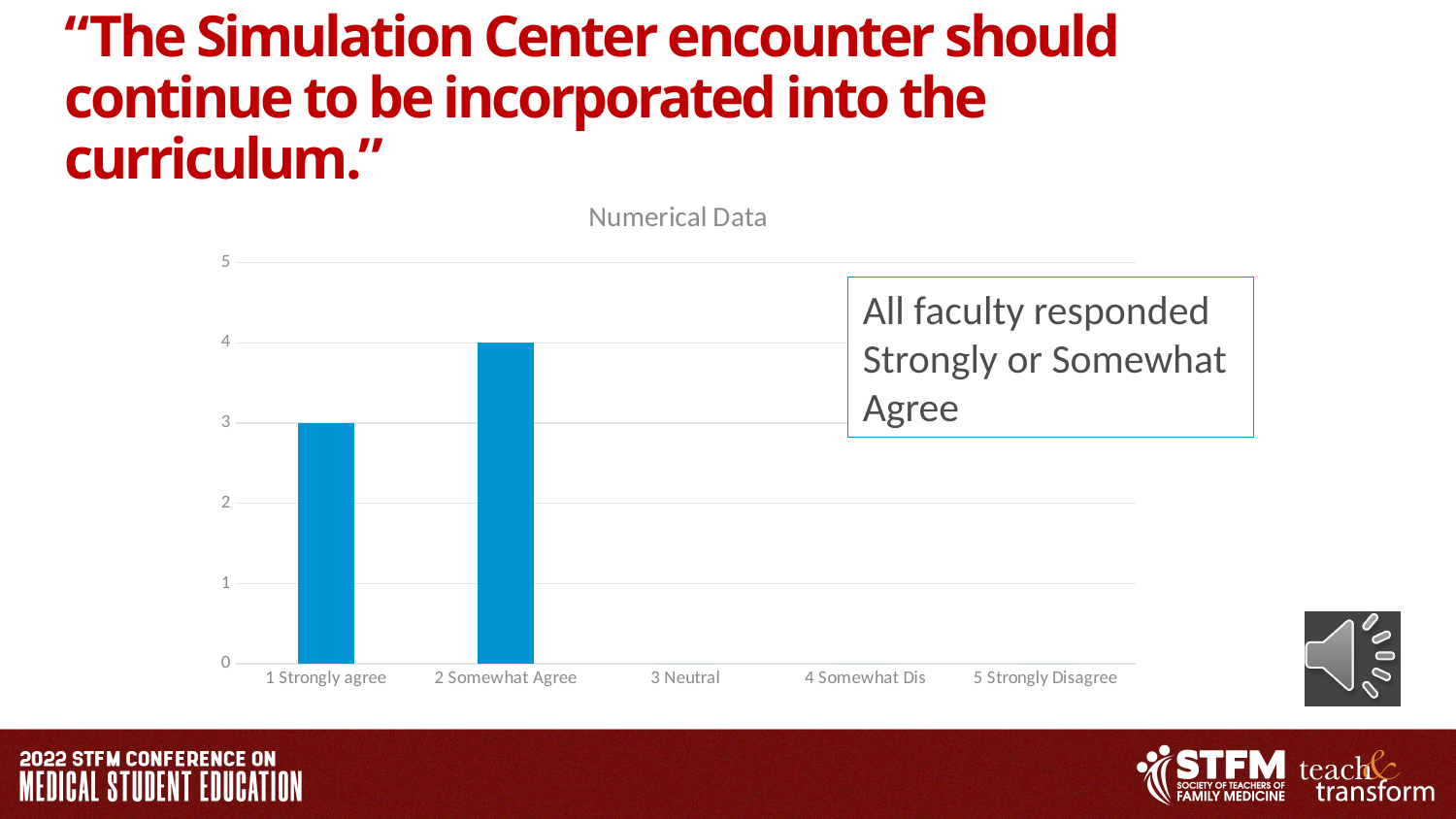
What is the difference between the values for "2 Somewhat Agree" and "1 Strongly agree"? 1 What does the text box on the chart say? All faculty responded Strongly or Somewhat Agree What is the value for "3 Neutral"? 0 What is the value for "2 Somewhat Agree"? 4 What kind of chart is shown on the slide? bar chart What is the total of the values for "1 Strongly agree" and "2 Somewhat Agree"? 7 What is the title of the chart? Numerical Data Which category has the highest value? 2 Somewhat Agree Is the value for "2 Somewhat Agree" greater or less than 5? less What is the value for "1 Strongly agree"? 3 Which is larger, the value for "1 Strongly agree" or the value for "2 Somewhat Agree"? 2 Somewhat Agree How many categories are shown on the x axis of the chart? 5